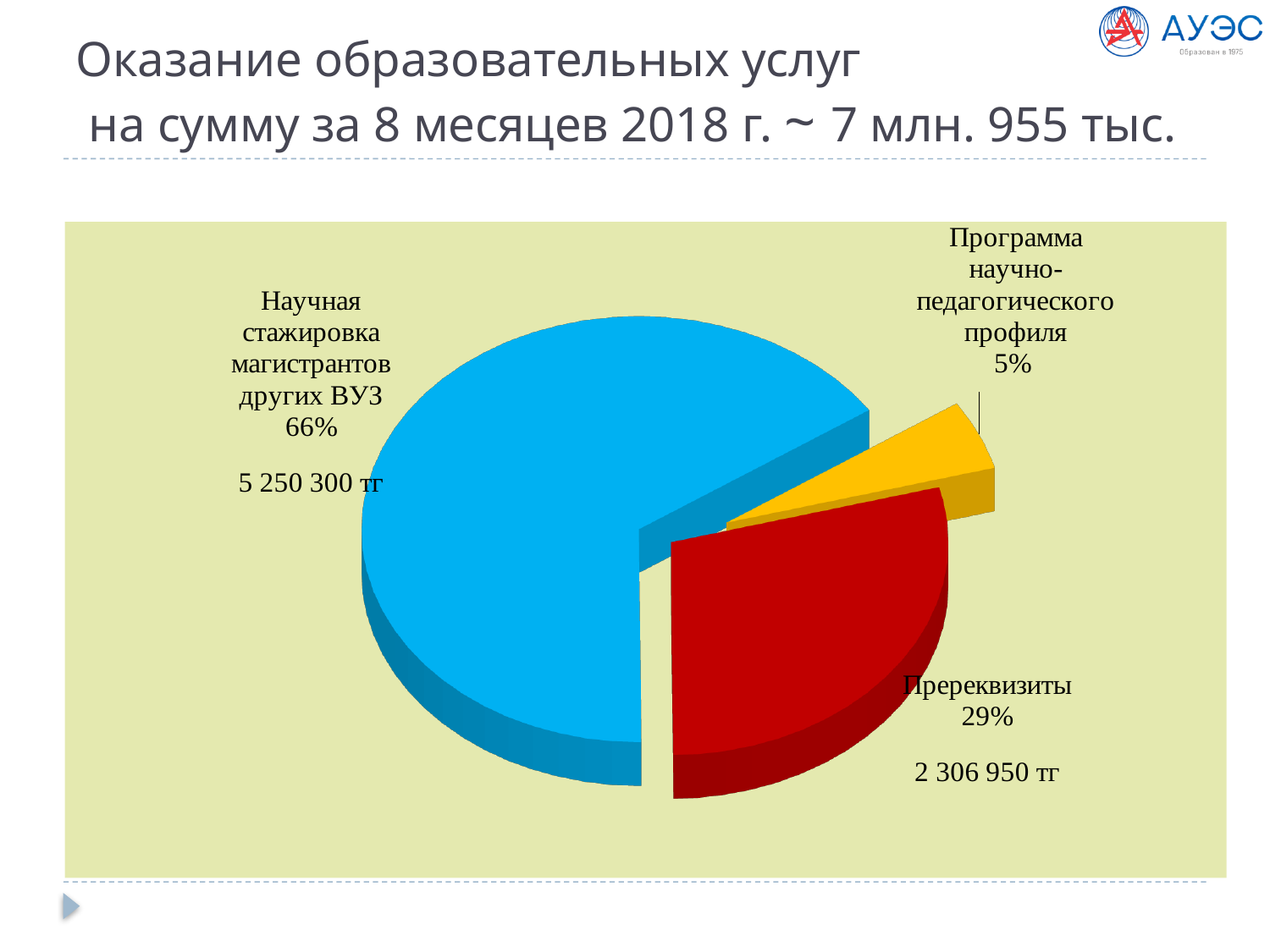
What share of the pie does "Научная стажировка магистрантов других ВУЗ" represent? 66% What kind of chart is shown on the slide? Pie chart What amount in тг is shown for "Научная стажировка магистрантов других ВУЗ"? 5 250 300 тг By how many percentage points does the share of "Научная стажировка магистрантов других ВУЗ" exceed the share of "Пререквизиты"? 37% What share of the pie does "Пререквизиты" represent? 29% Which is larger: the share for "Пререквизиты" or the share for "Программа научно-педагогического профиля"? Пререквизиты Which category has the smallest slice of the pie? Программа научно-педагогического профиля How many slices does the pie chart have? 3 What amount in тг is shown for "Пререквизиты"? 2 306 950 тг Which category has the largest slice of the pie? Научная стажировка магистрантов других ВУЗ What share of the pie does "Программа научно-педагогического профиля" represent? 5% What colour is the slice for "Пререквизиты"? Red